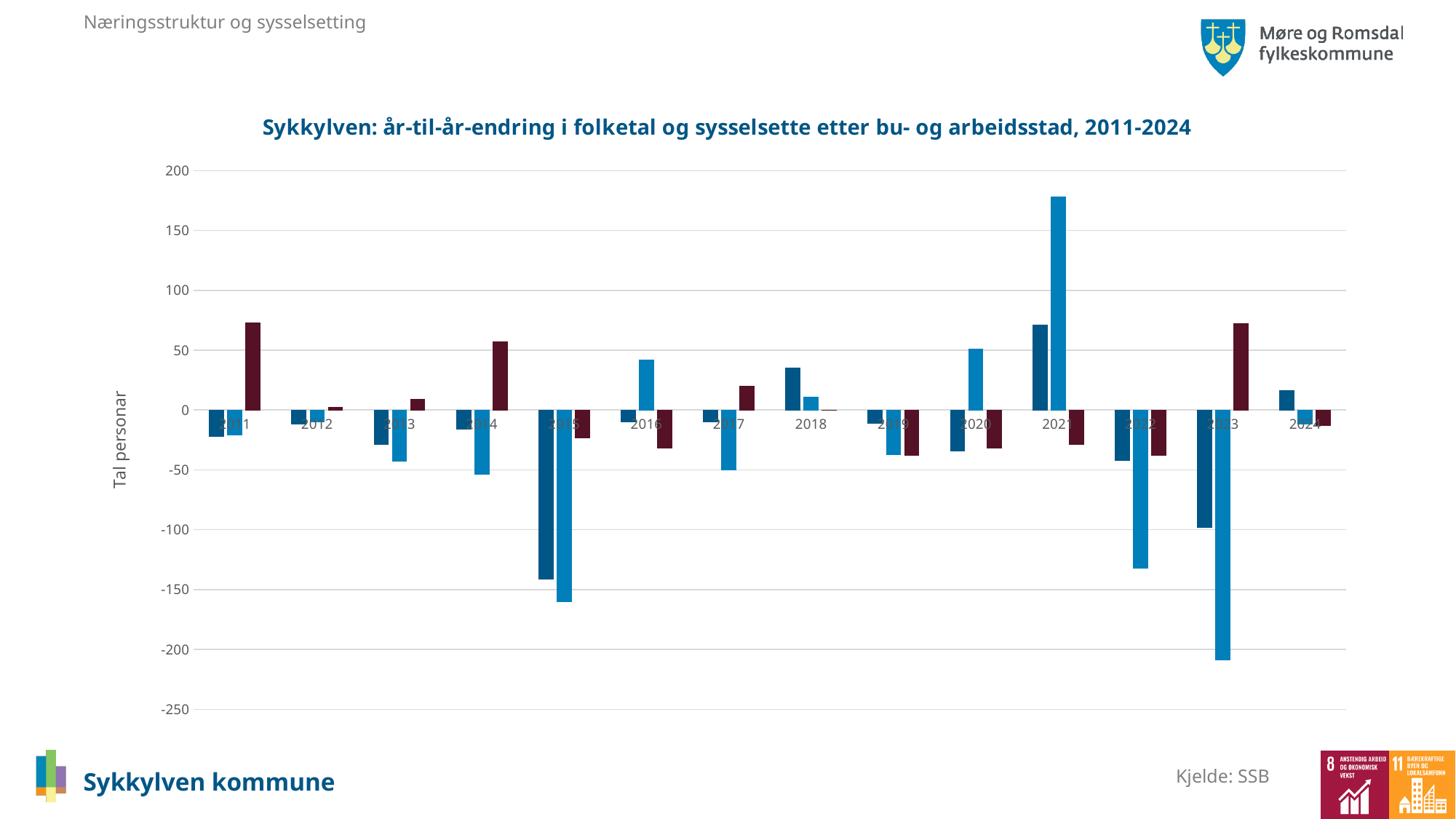
What kind of chart is shown on the slide? bar chart Is the value of the light blue bar for 2022 greater or less than -100? less Is the value of the dark blue bar for 2015 greater or less than -100? less In which year does the chart show the lowest (most negative) bar? 2023 Is the value of the dark red bar for 2011 greater or less than 50? greater In which year does the chart show the tallest positive bar? 2021 How many bars are plotted for each year in the chart? 3 What is the label on the vertical axis of the chart? Tal personar What is the title of the chart? Sykkylven: år-til-år-endring i folketal og sysselsette etter bu- og arbeidsstad, 2011-2024 How many years are shown along the x axis of the chart? 14